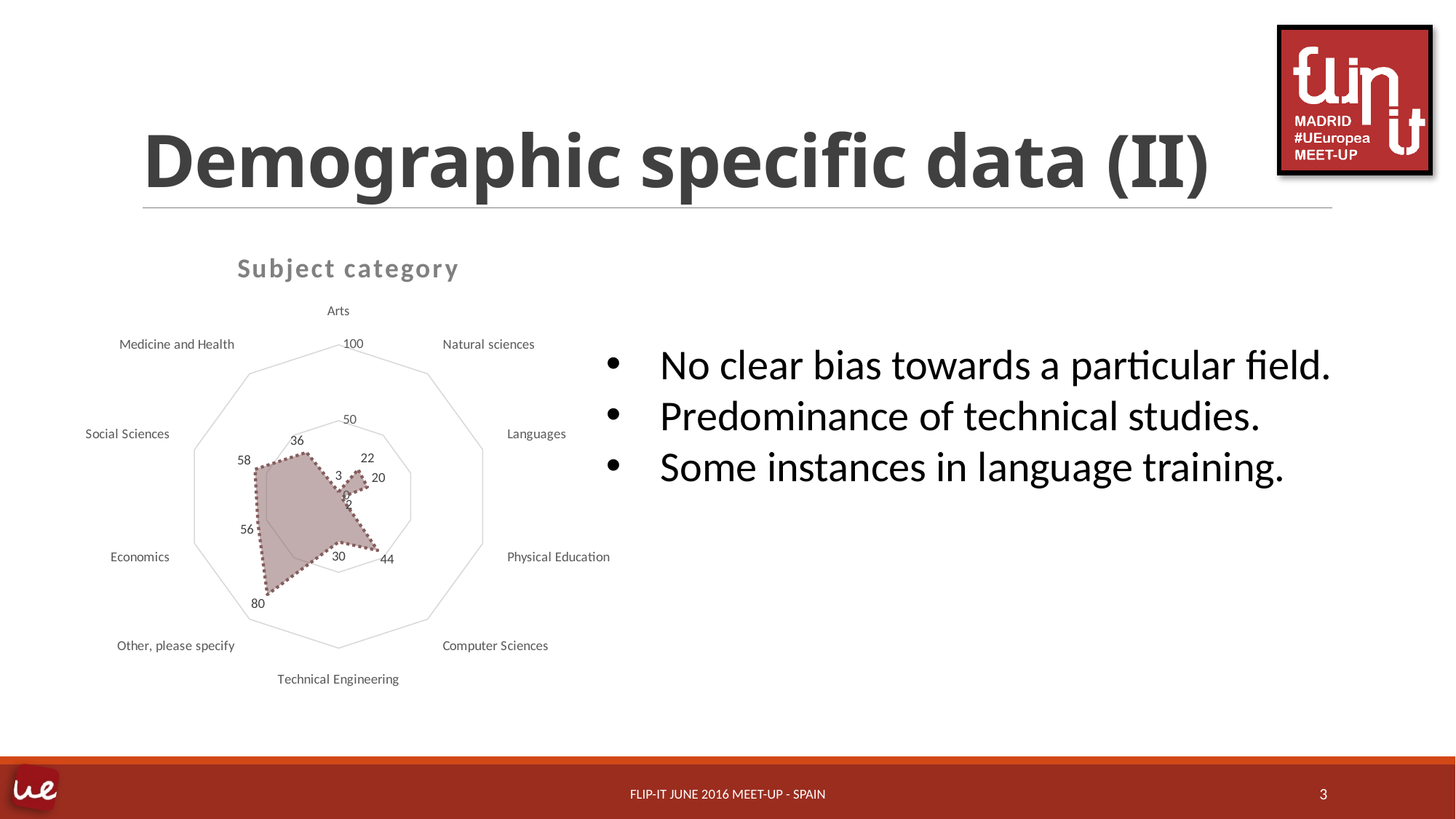
Which has a larger value, Natural sciences or Languages? Natural sciences How many subject categories are plotted on the radar chart? 10 What is the value for Social Sciences? 58 Which subject category has the highest value? Other, please specify What type of chart is shown under the title "Subject category"? radar chart What is the value for Economics? 56 What is the value for Technical Engineering? 30 What is the value for "Other, please specify"? 80 Is the value for Computer Sciences greater or less than 50? less What is the value for Computer Sciences? 44 What is the value for Medicine and Health? 36 What is the difference between the values for "Other, please specify" and Economics? 24